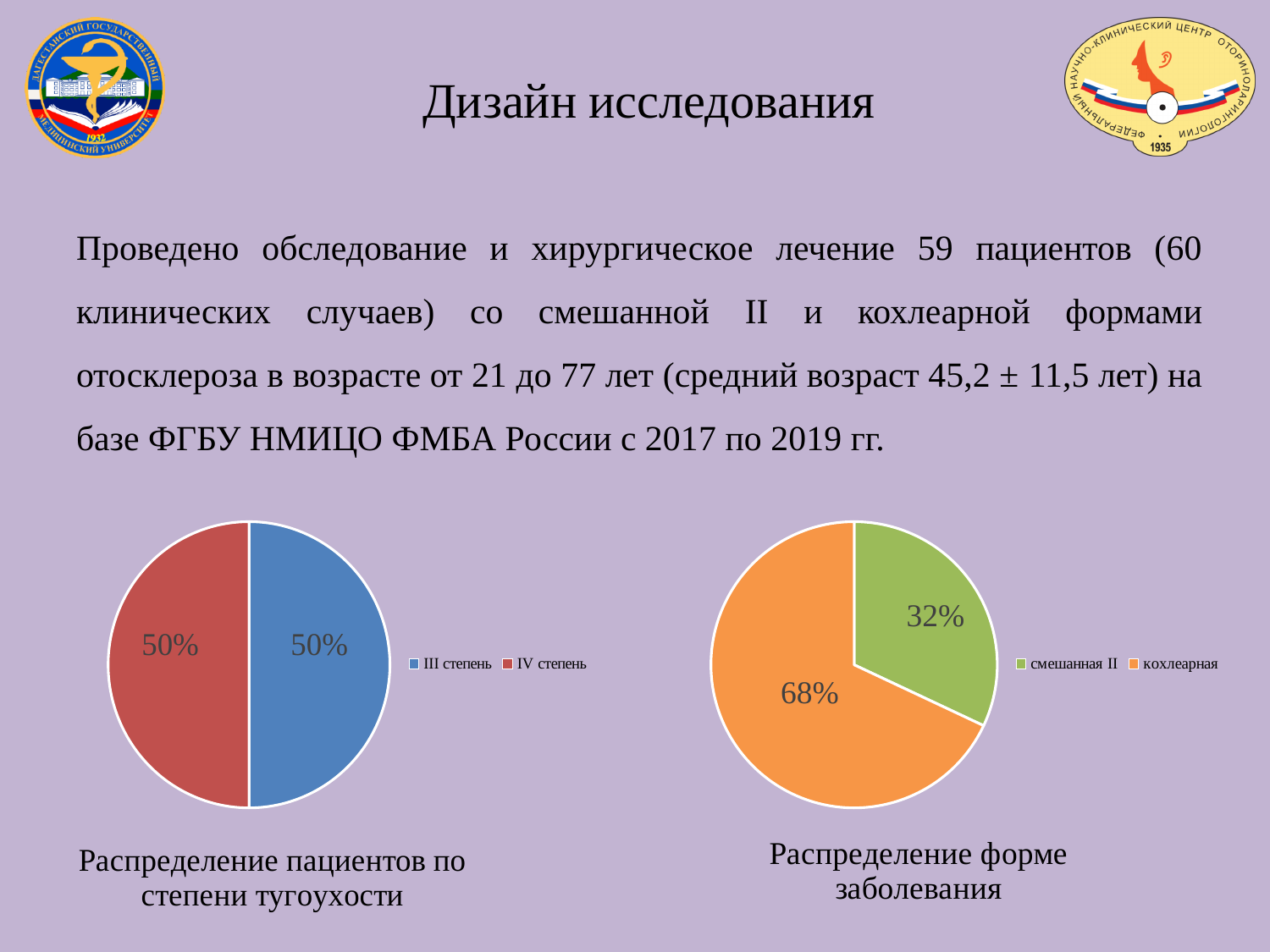
In the right pie chart (Распределение форме заболевания), which is larger: смешанная II or кохлеарная? кохлеарная In the right pie chart (Распределение форме заболевания), what share is labelled смешанная II? 32% In the left pie chart (Распределение пациентов по степени тугоухости), what share of patients have III степень? 50% How many entries does the legend of the right pie chart (Распределение форме заболевания) list? 2 In the right pie chart (Распределение форме заболевания), what share is labelled кохлеарная? 68% In the right pie chart (Распределение форме заболевания), which category has the largest share? кохлеарная What type of chart is used for Распределение пациентов по степени тугоухости? Pie chart In the right pie chart (Распределение форме заболевания), what colour is the кохлеарная slice? Orange How many slices does the left pie chart (Распределение пациентов по степени тугоухости) have? 2 In the right pie chart (Распределение форме заболевания), what is the difference in percentage points between кохлеарная and смешанная II? 36 In the right pie chart (Распределение форме заболевания), which category has the smallest share? смешанная II In the left pie chart (Распределение пациентов по степени тугоухости), what share of patients have IV степень? 50%